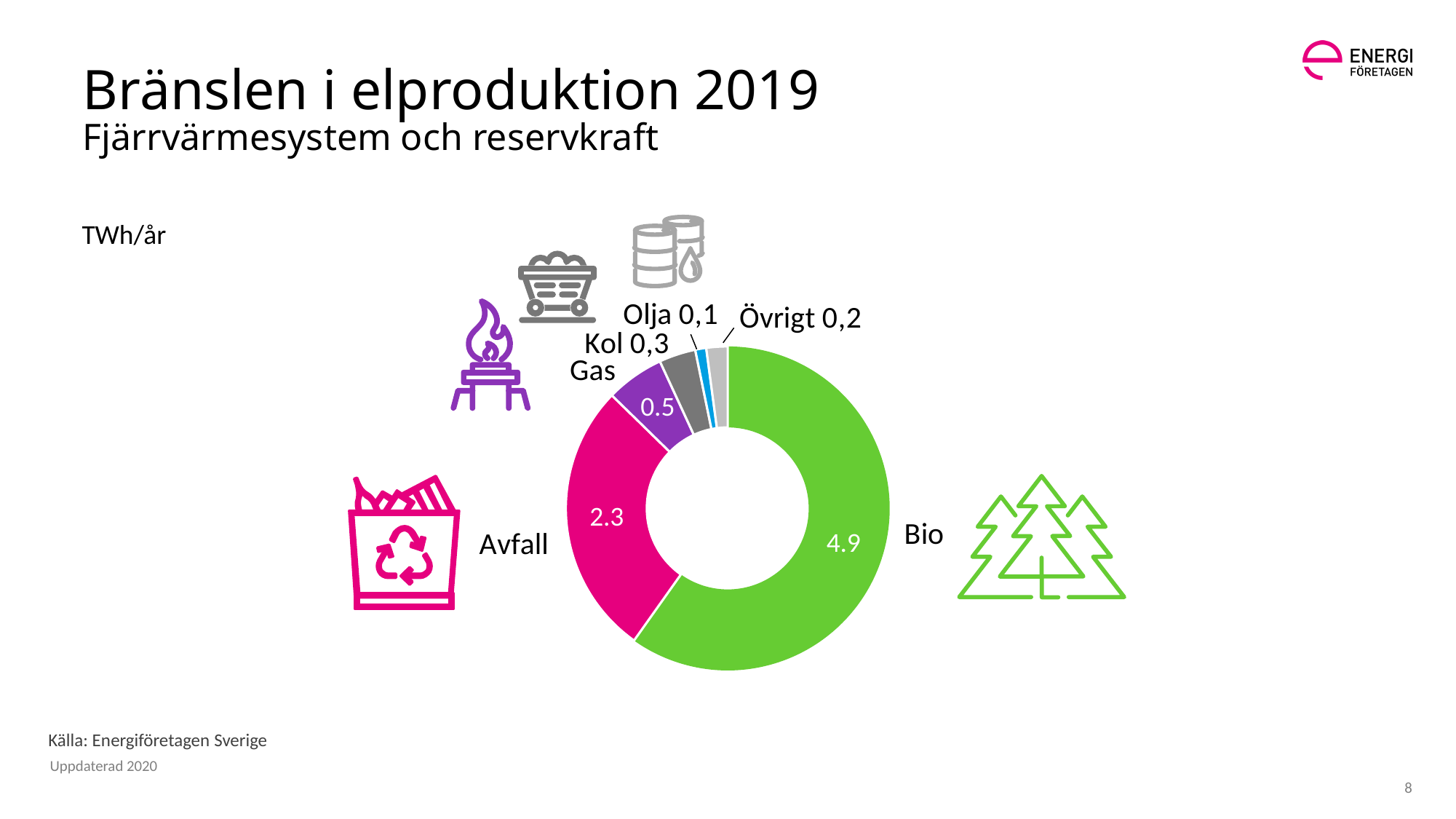
Which is larger, the value for Gas or the value for Kol? Gas What is the value for Gas in the donut chart? 0.5 Which category has the largest share of the donut chart? Bio What is the difference between the values for Bio and Avfall? 2.6 What is the value for Avfall in the donut chart? 2.3 What unit are the values in the chart given in? TWh/år What is the value for Bio in the donut chart? 4.9 How many categories are shown in the donut chart? 6 What is the value for Kol in the donut chart? 0,3 What is the value for Olja in the donut chart? 0,1 What is the value for Övrigt in the donut chart? 0,2 Which category has the smallest value in the donut chart? Olja